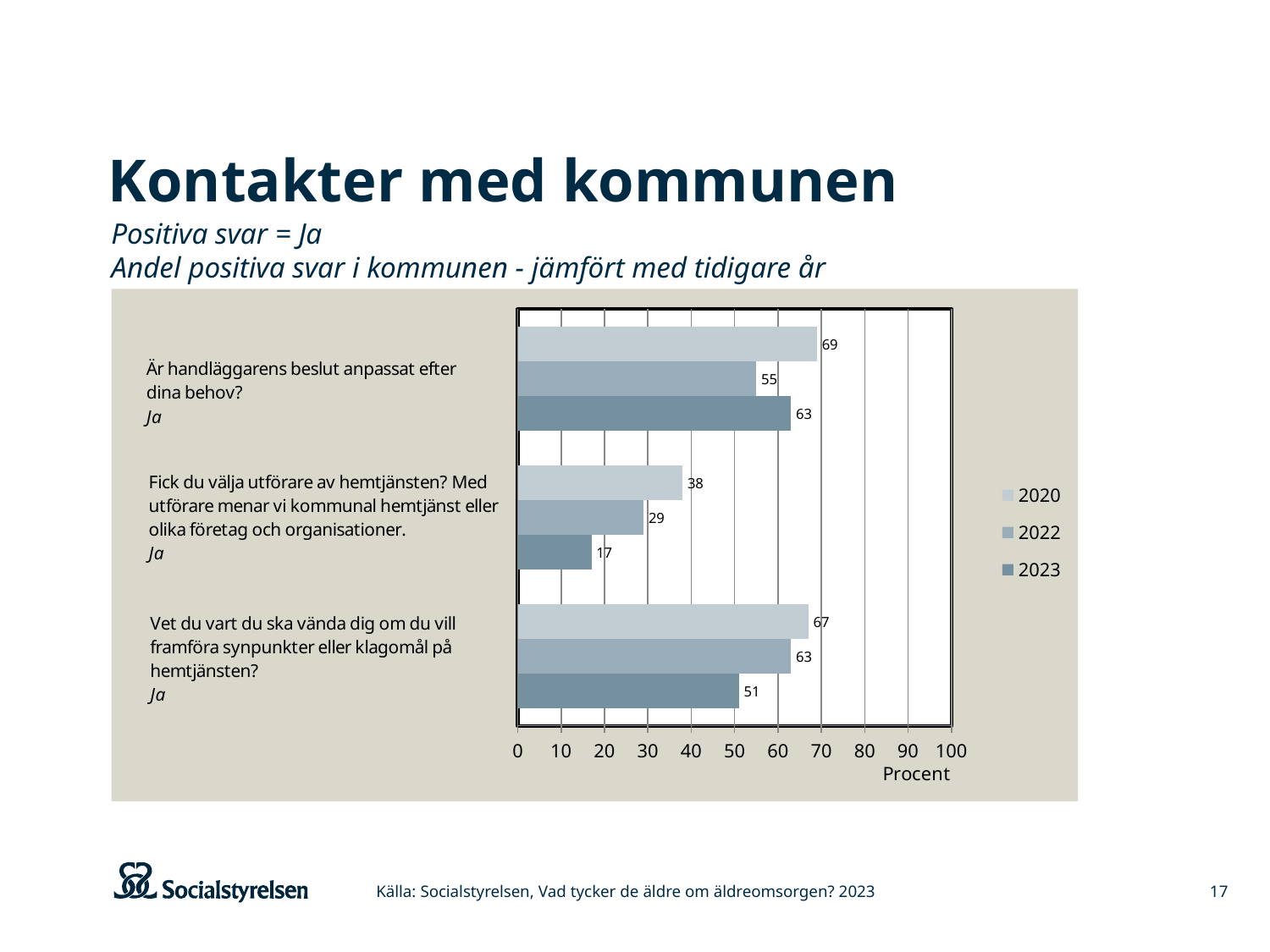
Which question has the lowest 2023 value? Fick du välja utförare av hemtjänsten? What is the difference between the 2020 and 2023 values for "Fick du välja utförare av hemtjänsten?"? 21 What is the 2023 value for "Är handläggarens beslut anpassat efter dina behov?"? 63 For "Vet du vart du ska vända dig om du vill framföra synpunkter eller klagomål på hemtjänsten?", which year has the larger value, 2020 or 2023? 2020 How many questions (categories) are shown in the chart? 3 What is the 2022 value for "Vet du vart du ska vända dig om du vill framföra synpunkter eller klagomål på hemtjänsten?"? 63 What is the difference between the 2020 and 2022 values for "Är handläggarens beslut anpassat efter dina behov?"? 14 What is the label on the horizontal axis of the chart? Procent How many series does the legend list? 3 What is the 2020 value for "Fick du välja utförare av hemtjänsten?"? 38 Which question has the highest 2020 value? Är handläggarens beslut anpassat efter dina behov? What kind of chart is shown on the slide? Bar chart